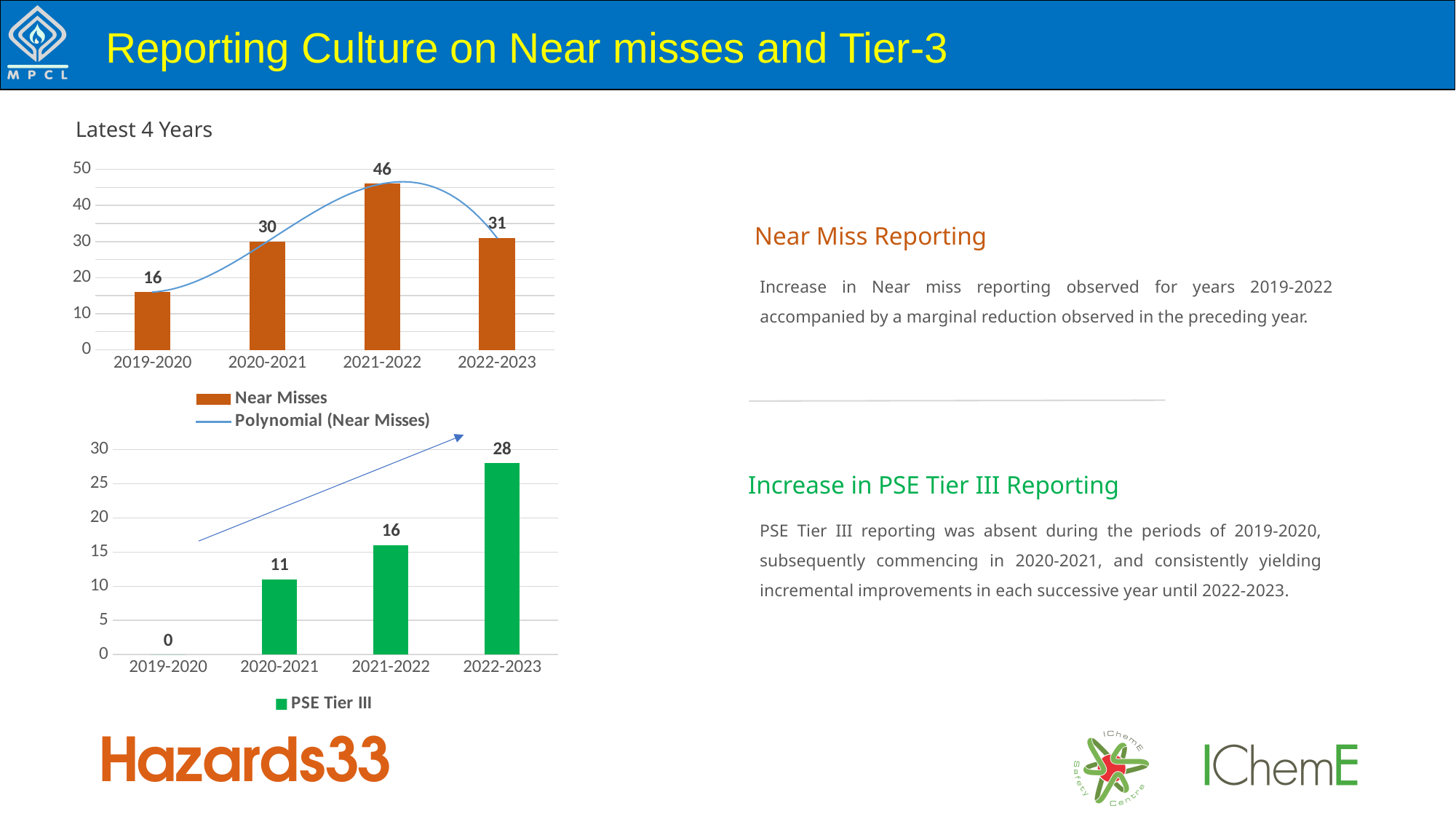
In the top chart (Near Misses), what is the value for 2019-2020? 16 In the bottom chart (PSE Tier III), what is the value for 2020-2021? 11 In the top chart (Near Misses), what is the difference between the values for 2021-2022 and 2022-2023? 15 In the top chart (Near Misses), what is the value for 2021-2022? 46 In the bottom chart (PSE Tier III), how many years are shown on the x axis? 4 In the bottom chart (PSE Tier III), which year has the highest value? 2022-2023 In the bottom chart (PSE Tier III), what is the value for 2019-2020? 0 In the top chart (Near Misses), how many series does the legend list? 2 Which is larger: the Near Misses value for 2020-2021 in the top chart or the PSE Tier III value for 2022-2023 in the bottom chart? Near Misses for 2020-2021 In the bottom chart (PSE Tier III), do the values rise or fall from 2019-2020 to 2022-2023? rise In the top chart (Near Misses), which year has the lowest value? 2019-2020 In the top chart (Near Misses), which year has the highest value? 2021-2022